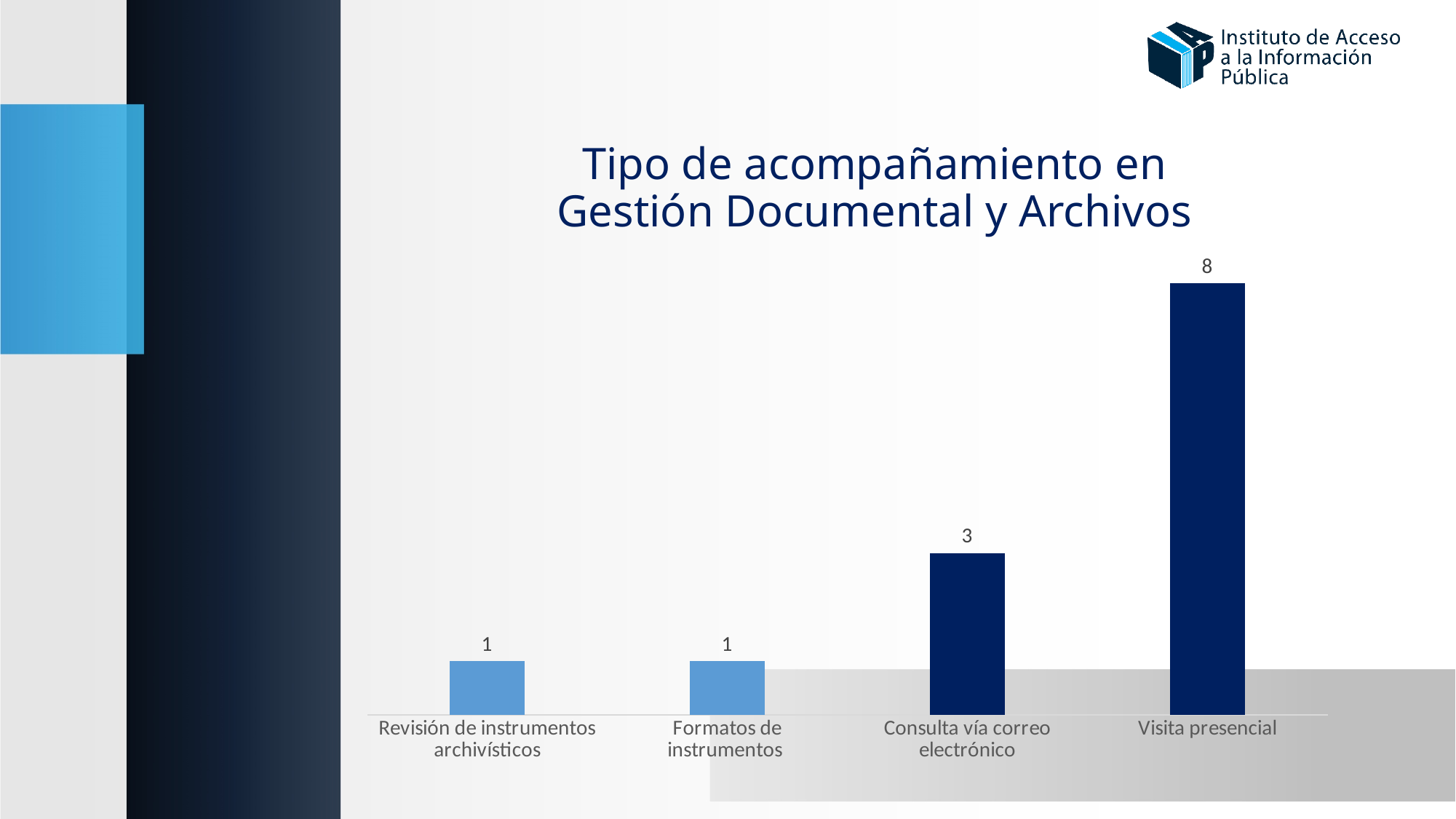
What is the value for Formatos de instrumentos? 1 What is the value for Consulta vía correo electrónico? 3 How many categories are shown in the chart? 4 What is the title of the chart? Tipo de acompañamiento en Gestión Documental y Archivos What is the value for Visita presencial? 8 Which is larger, the value for Consulta vía correo electrónico or the value for Revisión de instrumentos archivísticos? Consulta vía correo electrónico What kind of chart is shown on the slide? Bar chart What is the difference between the values for Visita presencial and Consulta vía correo electrónico? 5 Do the values rise or fall from left to right across the categories? Rise What is the difference between the values for Consulta vía correo electrónico and Formatos de instrumentos? 2 What is the value for Revisión de instrumentos archivísticos? 1 Which category has the highest value? Visita presencial